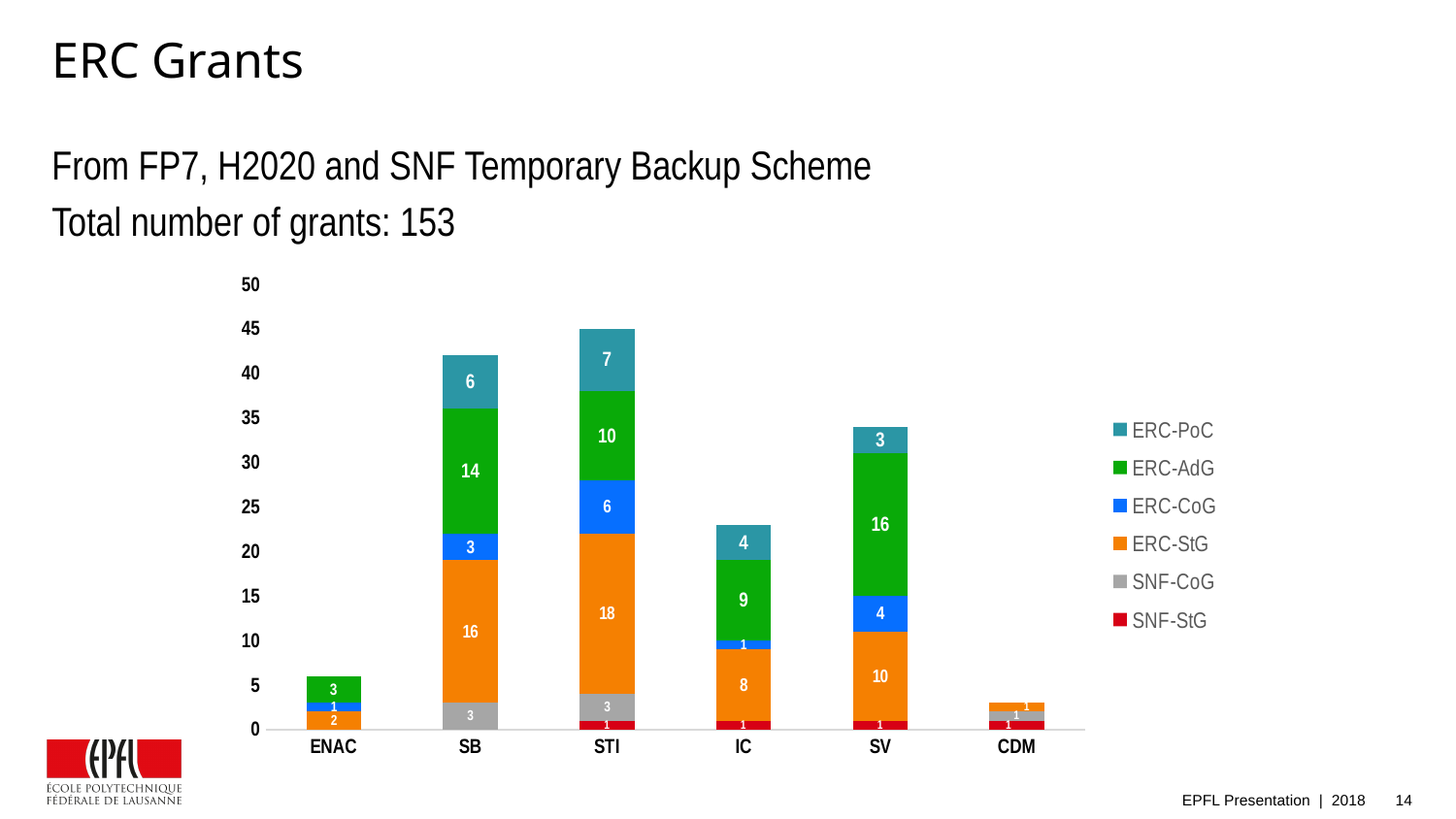
What kind of chart is shown on the slide? Stacked bar chart Which category has the shortest stacked bar? CDM What is the ERC-PoC value for SB? 6 Which category has the tallest stacked bar? STI What is the difference between the ERC-AdG values for SB and STI? 4 What is the total of the stacked bar for SB? 42 How many categories are shown on the x axis? 6 What is the ERC-CoG value for IC? 1 Which is larger, the ERC-StG value for SB or the ERC-StG value for SV? SB How many series does the legend list? 6 What is the ERC-AdG value for SV? 16 What is the ERC-StG value for STI? 18